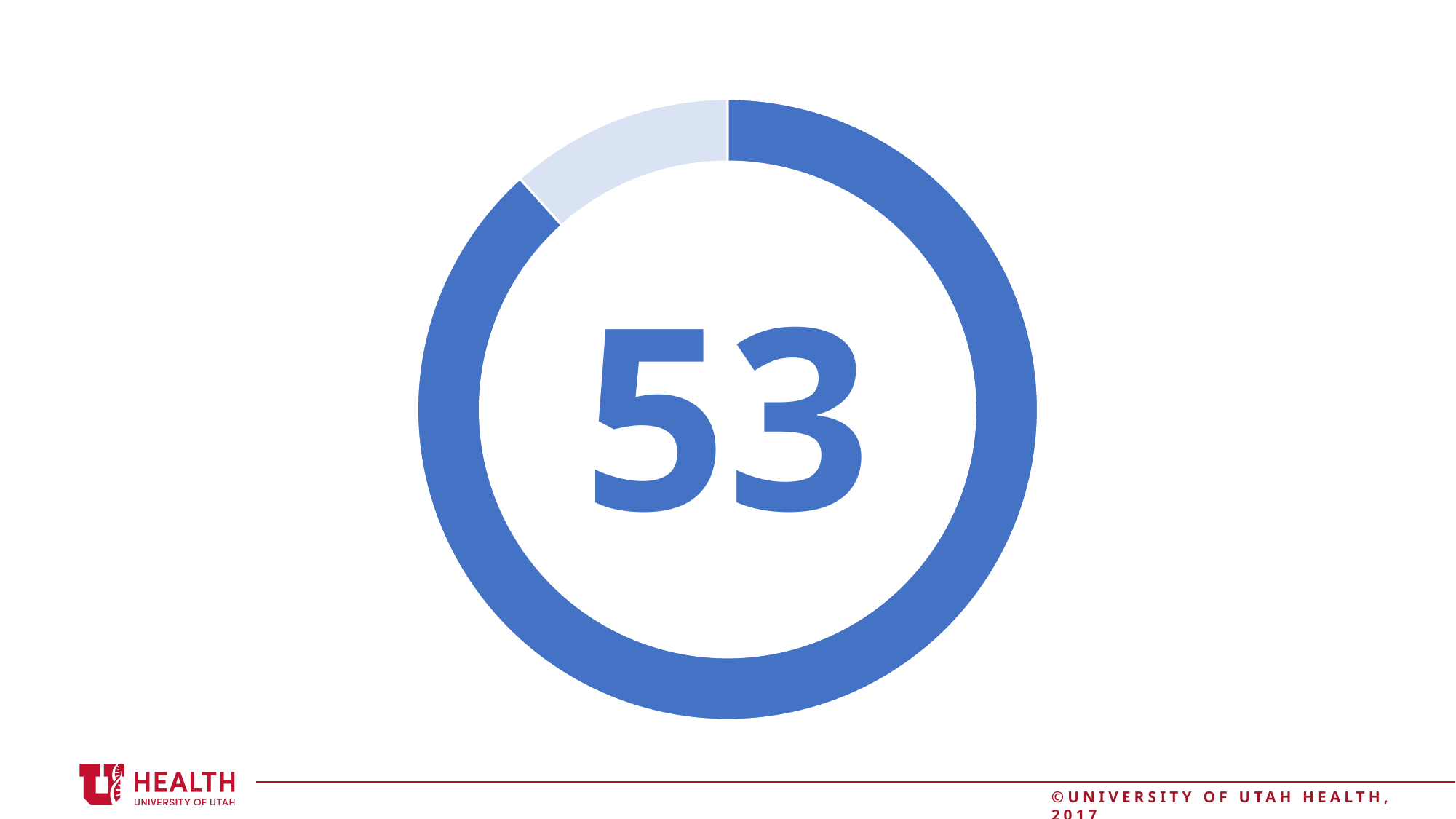
Does the light blue segment cover more or less than a quarter of the ring? Less Does the doughnut chart have a legend? No Which segment of the doughnut chart is larger, the dark blue one or the light blue one? The dark blue one Does the dark blue segment cover more or less than half of the ring? More What number is displayed in the center of the doughnut chart? 53 How many segments does the doughnut chart have? 2 What kind of chart is shown on the slide? Doughnut chart What colour is the larger segment of the doughnut chart? Dark blue